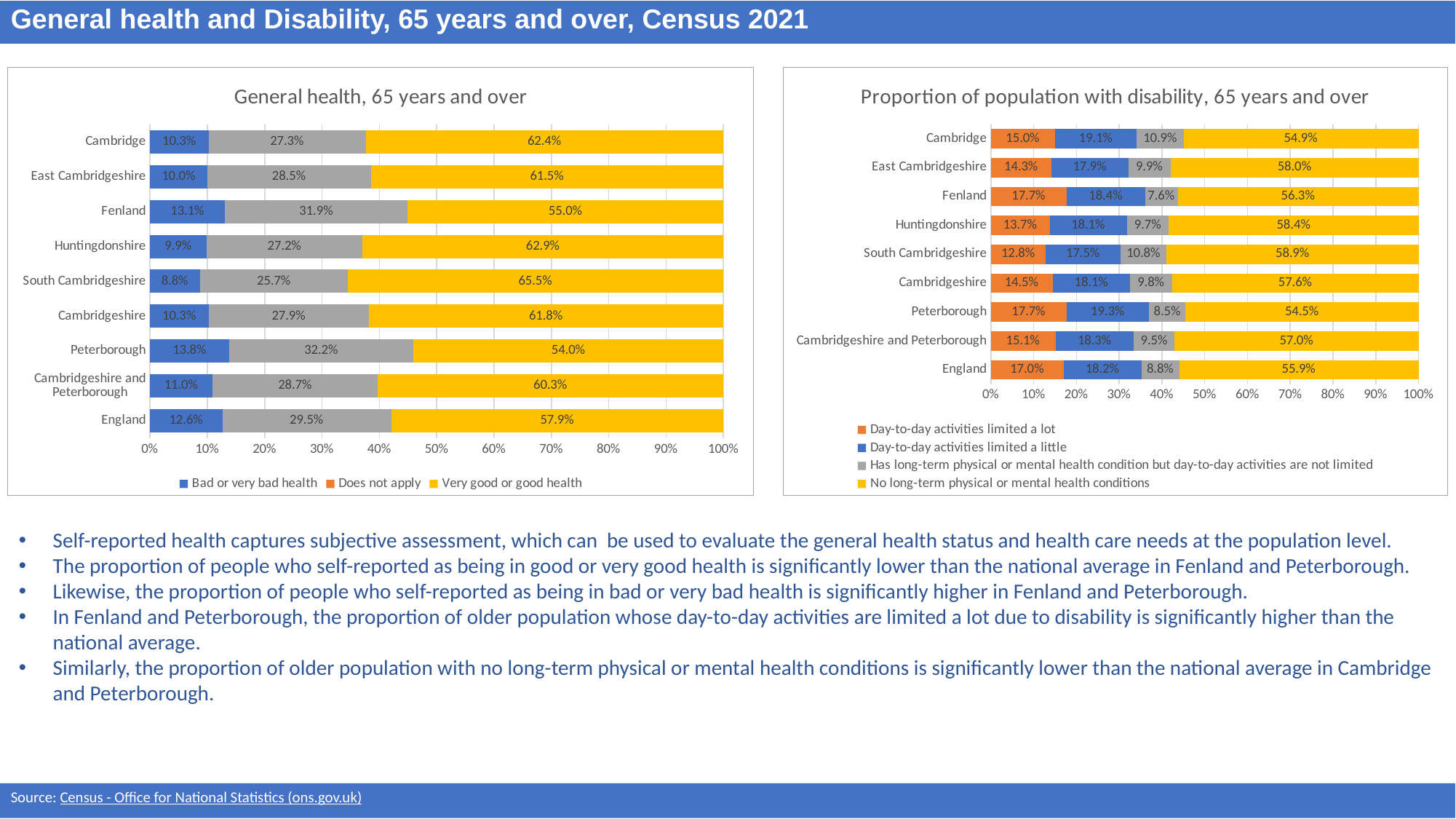
In the 'General health, 65 years and over' chart, which area has the lowest proportion reporting bad or very bad health? South Cambridgeshire In the 'Proportion of population with disability, 65 years and over' chart, which area has the lowest proportion with day-to-day activities limited a lot? South Cambridgeshire How many series does the legend of the 'Proportion of population with disability, 65 years and over' chart list? 4 What type of chart is the 'General health, 65 years and over' chart? Stacked bar chart In the 'General health, 65 years and over' chart, how many areas are shown? 9 In the 'Proportion of population with disability, 65 years and over' chart, which is larger: the share with no long-term conditions in Huntingdonshire or in Peterborough? Huntingdonshire In the 'Proportion of population with disability, 65 years and over' chart, what percentage of people in England have day-to-day activities limited a lot? 17.0% In the 'General health, 65 years and over' chart, how many percentage points higher is the very good or good health share for Cambridge than for England? 4.5 percentage points In the 'General health, 65 years and over' chart, what percentage of people in Fenland reported very good or good health? 55.0% In the 'Proportion of population with disability, 65 years and over' chart, what percentage of people in Cambridge have no long-term physical or mental health conditions? 54.9% In the 'General health, 65 years and over' chart, what percentage of people in Peterborough reported bad or very bad health? 13.8% In the 'General health, 65 years and over' chart, which area has the highest proportion reporting very good or good health? South Cambridgeshire